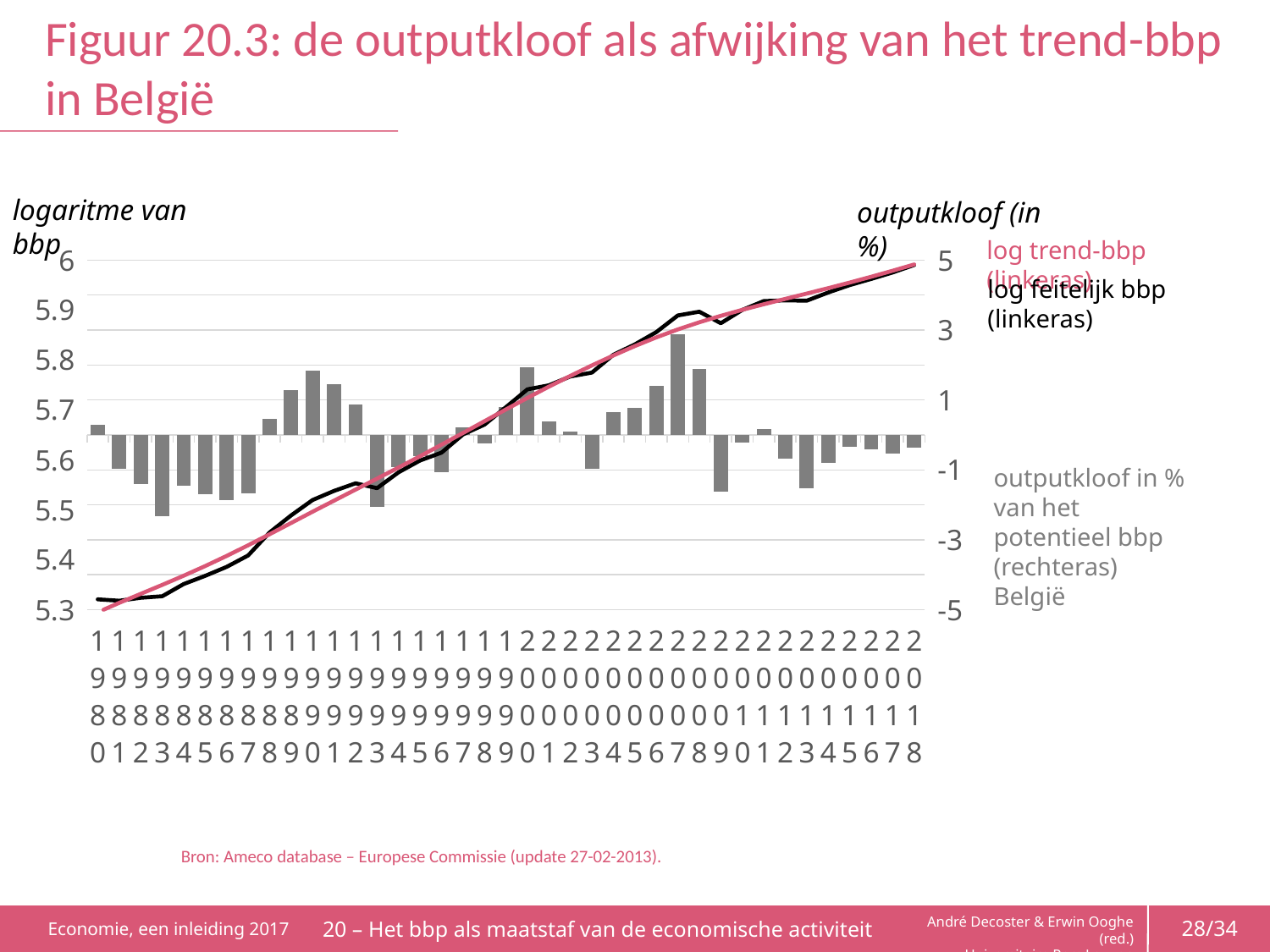
Is the log trend-bbp value for 2018 greater or less than 5.9? greater What kind of chart is shown on the slide? A combination of a bar chart and line chart How many years are plotted along the x axis? 39 Do the log trend-bbp and log feitelijk bbp lines rise or fall from 1980 to 2018? rise Which year has the highest outputkloof bar? 2007 Is the outputkloof value for 2007 greater or less than 1? greater Is the outputkloof value for 1983 greater or less than -1? less How many series does the legend list? 3 What is the title of the figure on the slide? Figuur 20.3: de outputkloof als afwijking van het trend-bbp in België In 2007, which is higher: log feitelijk bbp or log trend-bbp? log feitelijk bbp